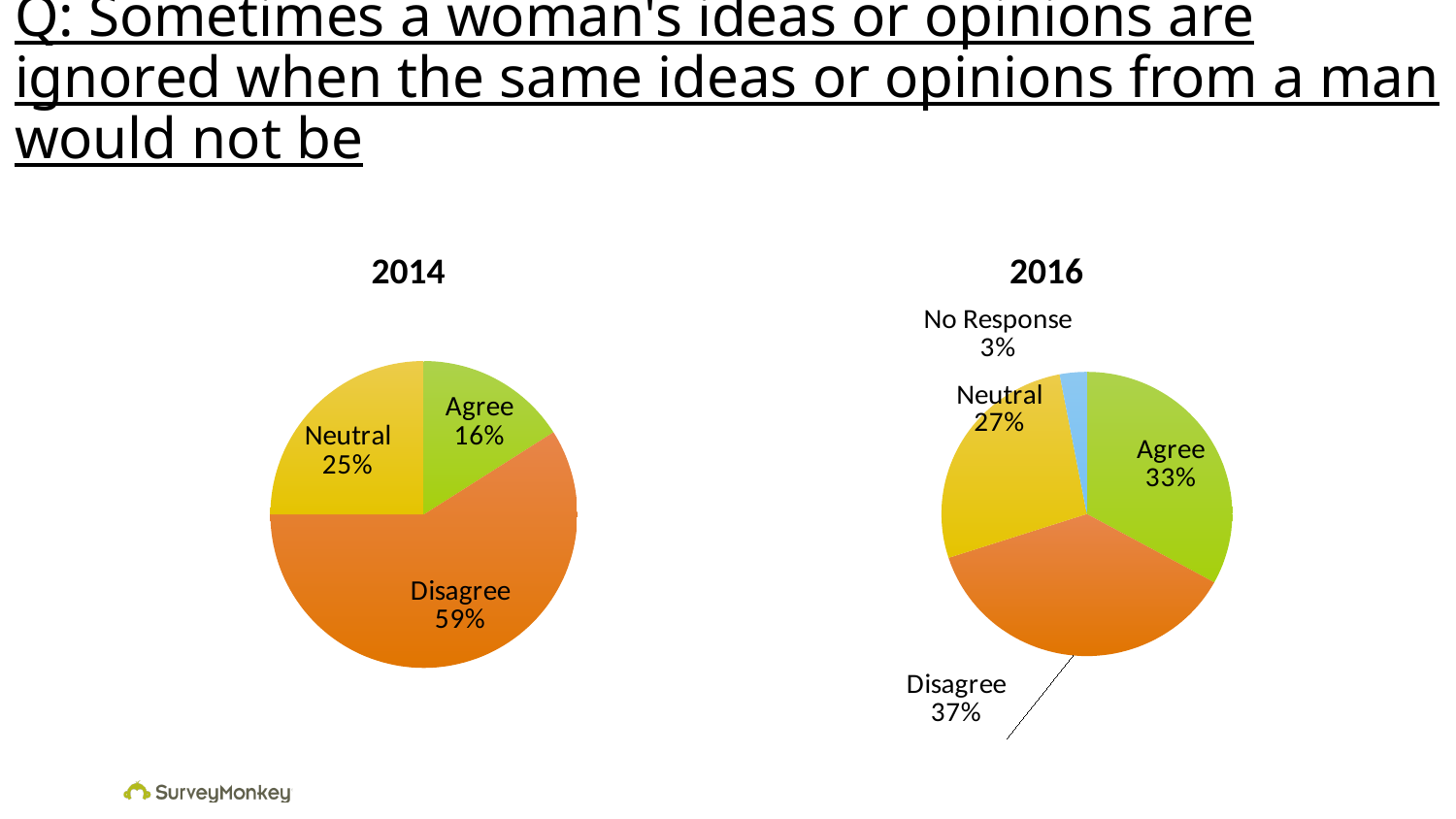
What is the difference between the Disagree share in 2014 and the Disagree share in 2016? 22% In the 2016 chart, what percentage of respondents chose Agree? 33% How many categories are shown in the 2014 chart? 3 In the 2016 chart, which category has the largest slice? Disagree In the 2014 chart, what percentage of respondents chose Disagree? 59% In the 2016 chart, which category has the smallest slice? No Response In the 2014 chart, which category has the largest slice? Disagree In the 2014 chart, which category has the smallest slice? Agree What type of chart is used for the 2014 data? Pie chart In the 2016 chart, what share is labelled No Response? 3% In the 2016 chart, which is larger: Agree or Neutral? Agree How many categories are shown in the 2016 chart? 4